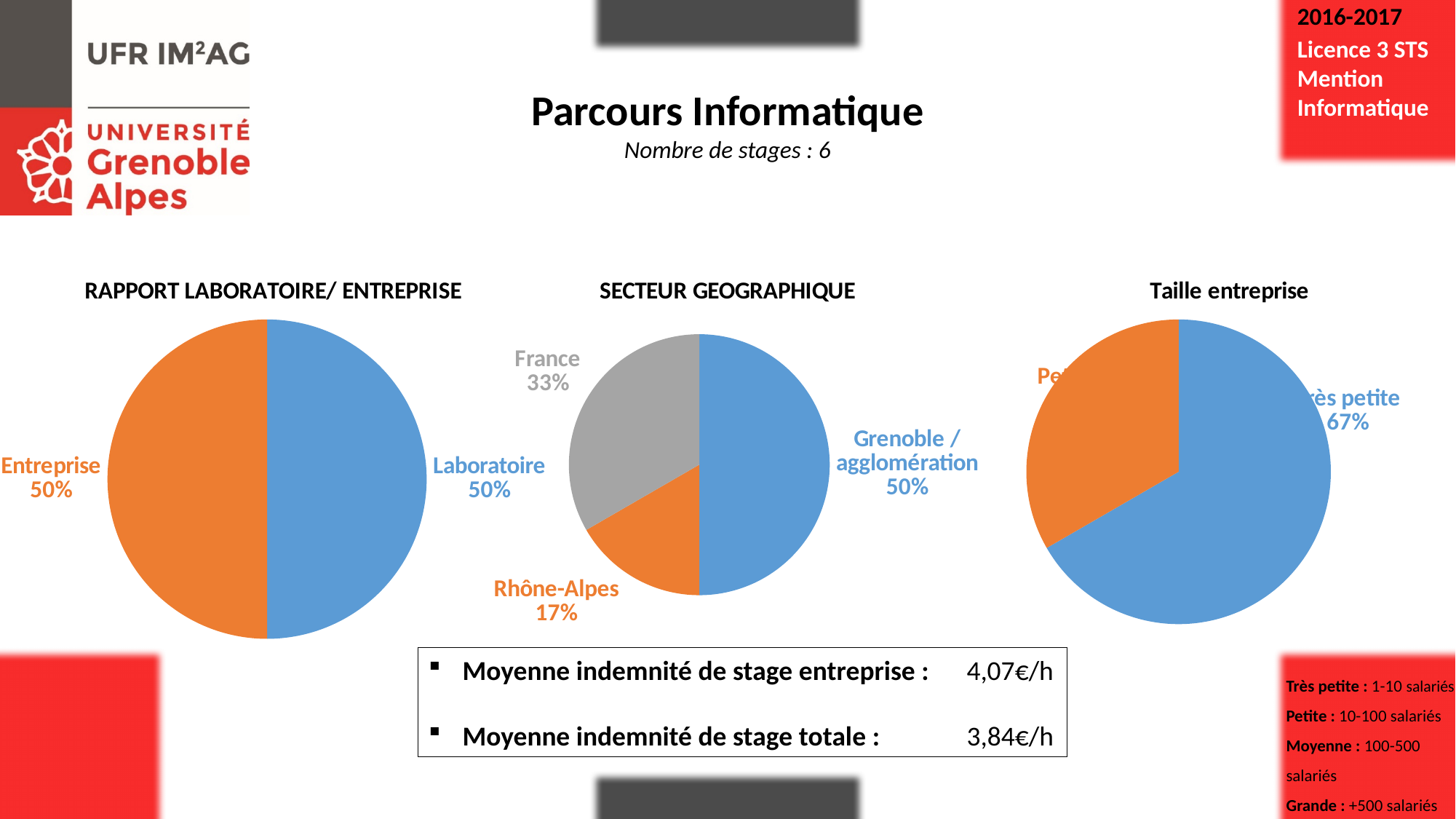
In the SECTEUR GEOGRAPHIQUE chart, what is the difference between the France share and the Rhône-Alpes share? 16% In the SECTEUR GEOGRAPHIQUE chart, what is the share for France? 33% In the SECTEUR GEOGRAPHIQUE chart, what share of internships is in Grenoble / agglomération? 50% In the RAPPORT LABORATOIRE/ ENTREPRISE chart, what is the share for Laboratoire? 50% In the Taille entreprise chart, which category has the largest share? Très petite In the Taille entreprise chart, what is the share for Très petite? 67% In the RAPPORT LABORATOIRE/ ENTREPRISE chart, what is the share for Entreprise? 50% In the SECTEUR GEOGRAPHIQUE chart, what is the share for Rhône-Alpes? 17% What type of chart is the Taille entreprise chart? Pie chart How many slices does the SECTEUR GEOGRAPHIQUE chart have? 3 In the SECTEUR GEOGRAPHIQUE chart, which sector has the largest share? Grenoble / agglomération In the SECTEUR GEOGRAPHIQUE chart, which sector has the smallest share? Rhône-Alpes